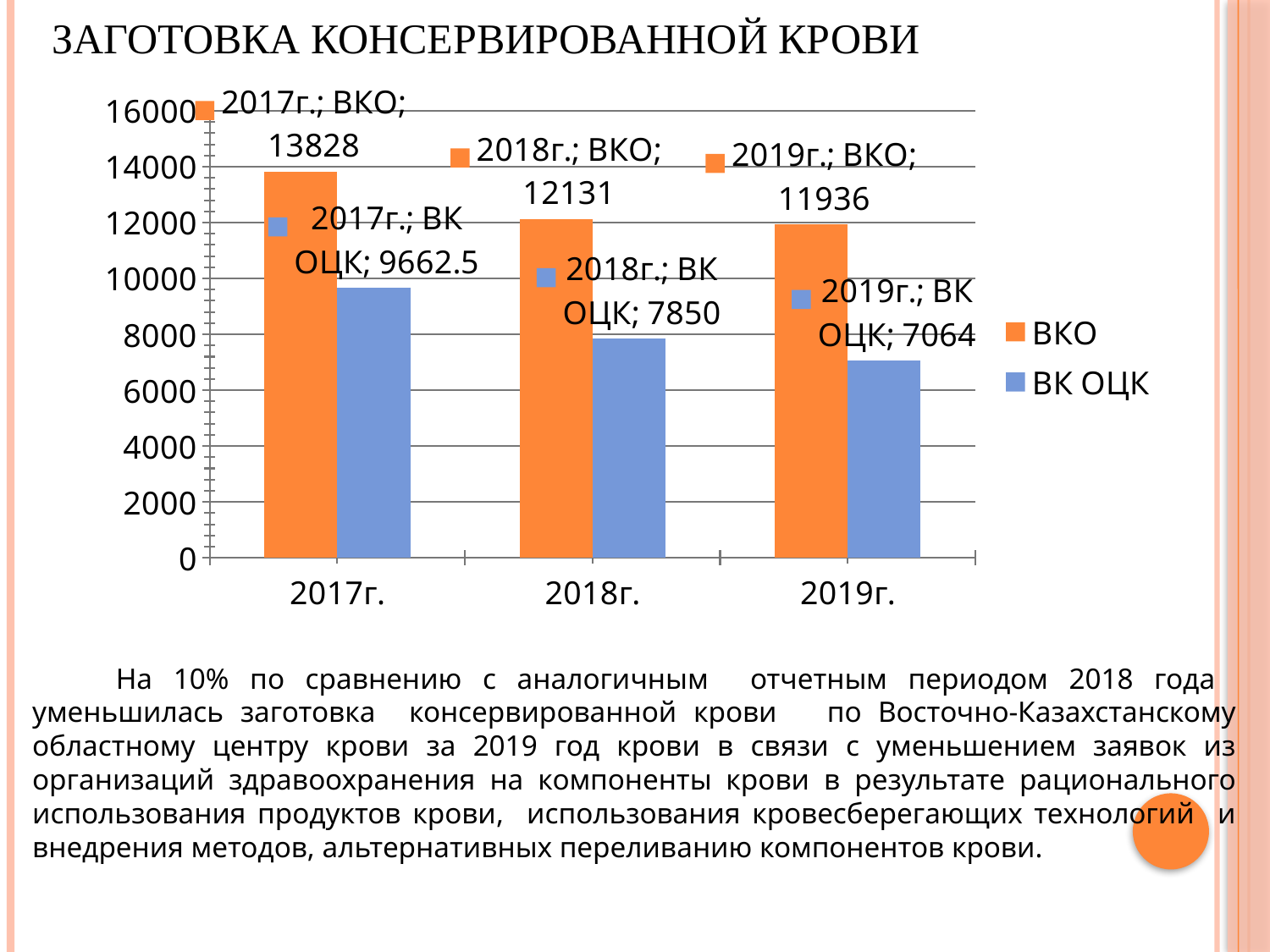
What is the value for ВК ОЦК in 2017г.? 9662.5 What kind of chart is shown on the slide? bar chart How many series does the legend list? 2 What is the difference between the ВКО value and the ВК ОЦК value in 2018г.? 4281 What is the value for ВКО in 2017г.? 13828 Do the ВКО values rise or fall from 2017г. to 2019г.? fall In which year is the ВК ОЦК value lowest? 2019г. What is the value for ВКО in 2019г.? 11936 In which year is the ВКО value highest? 2017г. What is the value for ВК ОЦК in 2019г.? 7064 How many years are shown on the x axis? 3 Which is larger in 2019г., ВКО or ВК ОЦК? ВКО